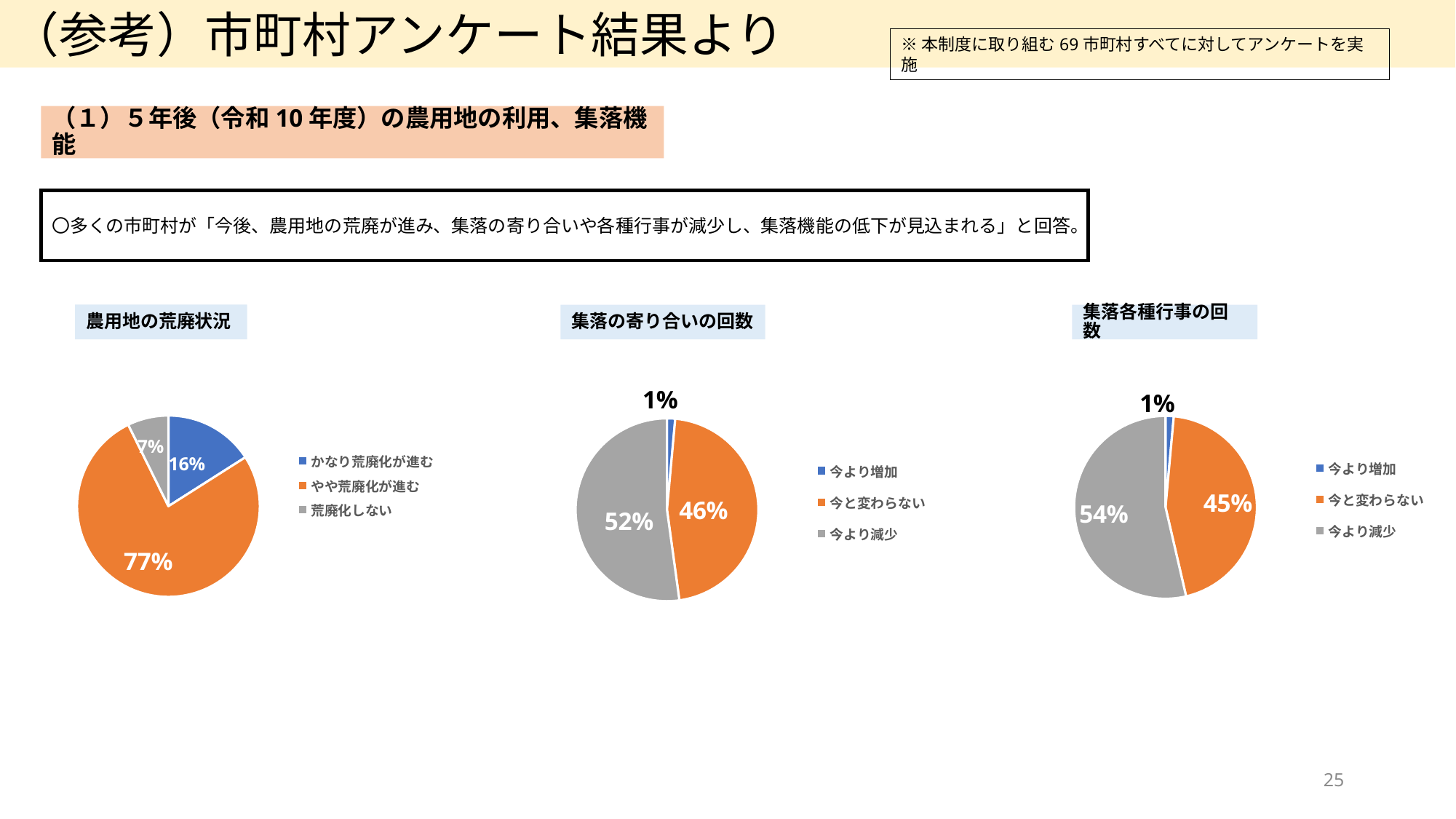
In the 集落の寄り合いの回数 chart, what percentage is shown for 今より増加? 1% In the 集落の寄り合いの回数 chart, what percentage is shown for 今より減少? 52% In the 集落の寄り合いの回数 chart, which is larger, 今と変わらない or 今より減少? 今より減少 How many categories does the legend of the 集落各種行事の回数 chart list? 3 In the 農用地の荒廃状況 chart, which category has the smallest share? 荒廃化しない In the 農用地の荒廃状況 chart, what percentage is shown for かなり荒廃化が進む? 16% What kind of chart is the 農用地の荒廃状況 chart? Pie chart In the 集落各種行事の回数 chart, what is the difference between the shares for 今より減少 and 今と変わらない? 9% In the 農用地の荒廃状況 chart, what is the difference between the shares for やや荒廃化が進む and かなり荒廃化が進む? 61% In the 集落各種行事の回数 chart, what percentage is shown for 今と変わらない? 45% In the 集落各種行事の回数 chart, which category has the largest share? 今より減少 In the 農用地の荒廃状況 chart, what percentage is shown for やや荒廃化が進む? 77%